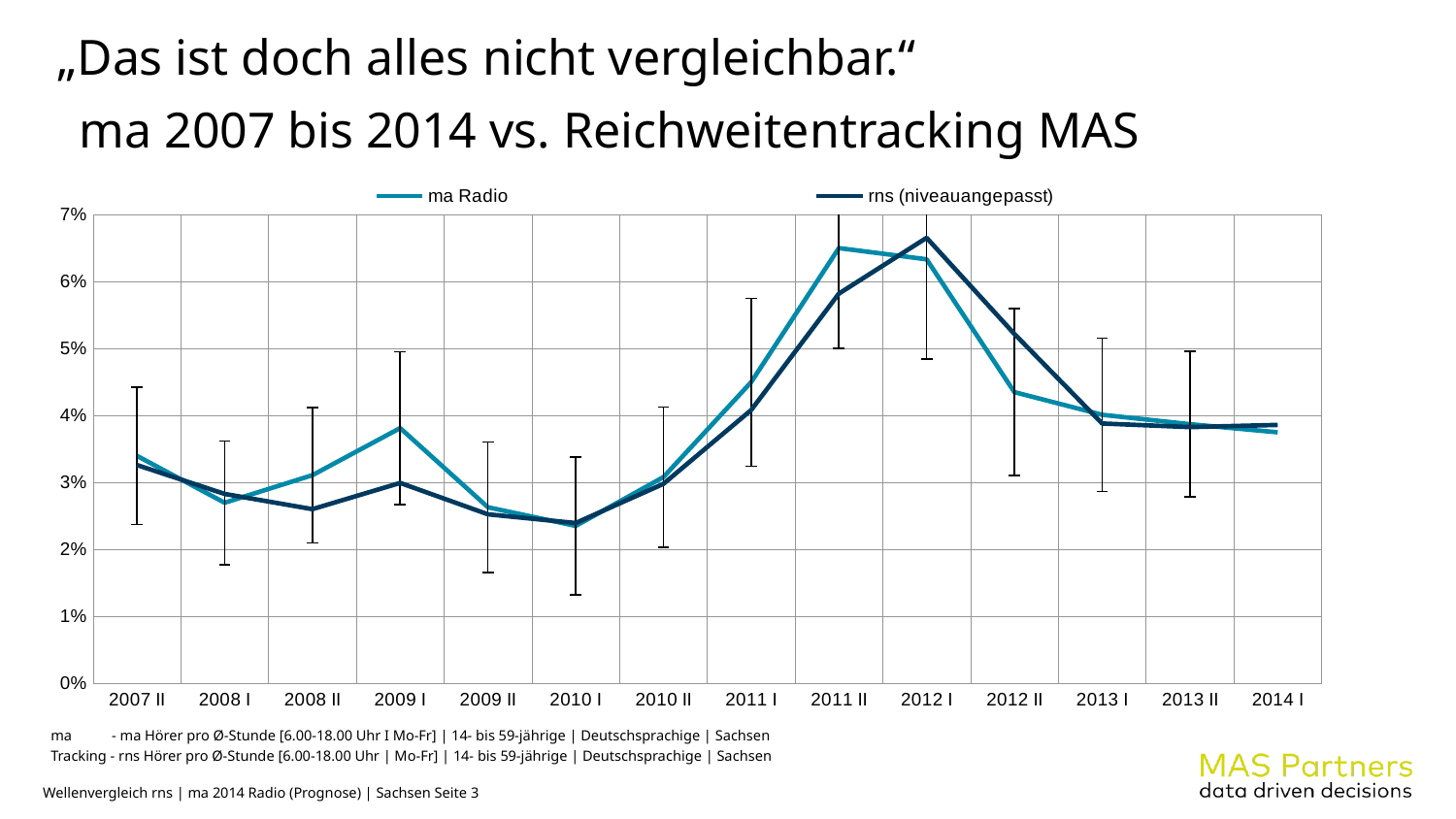
What kind of chart is shown on the slide? line chart Do the ma Radio values rise or fall from 2010 I to 2011 II? rise Is the value for ma Radio in 2011 II greater or less than 6%? greater In which period does the ma Radio series reach its highest value? 2011 II In which period does the ma Radio series reach its lowest value? 2010 I How many time periods are shown along the x axis? 14 In which period does the rns (niveauangepasst) series reach its highest value? 2012 I In 2012 II, which series has the larger value, ma Radio or rns (niveauangepasst)? rns (niveauangepasst) Is the value for rns (niveauangepasst) in 2010 I greater or less than 3%? less How many series does the legend list? 2 What are the two series named in the legend? ma Radio and rns (niveauangepasst) In 2009 I, which series has the larger value, ma Radio or rns (niveauangepasst)? ma Radio